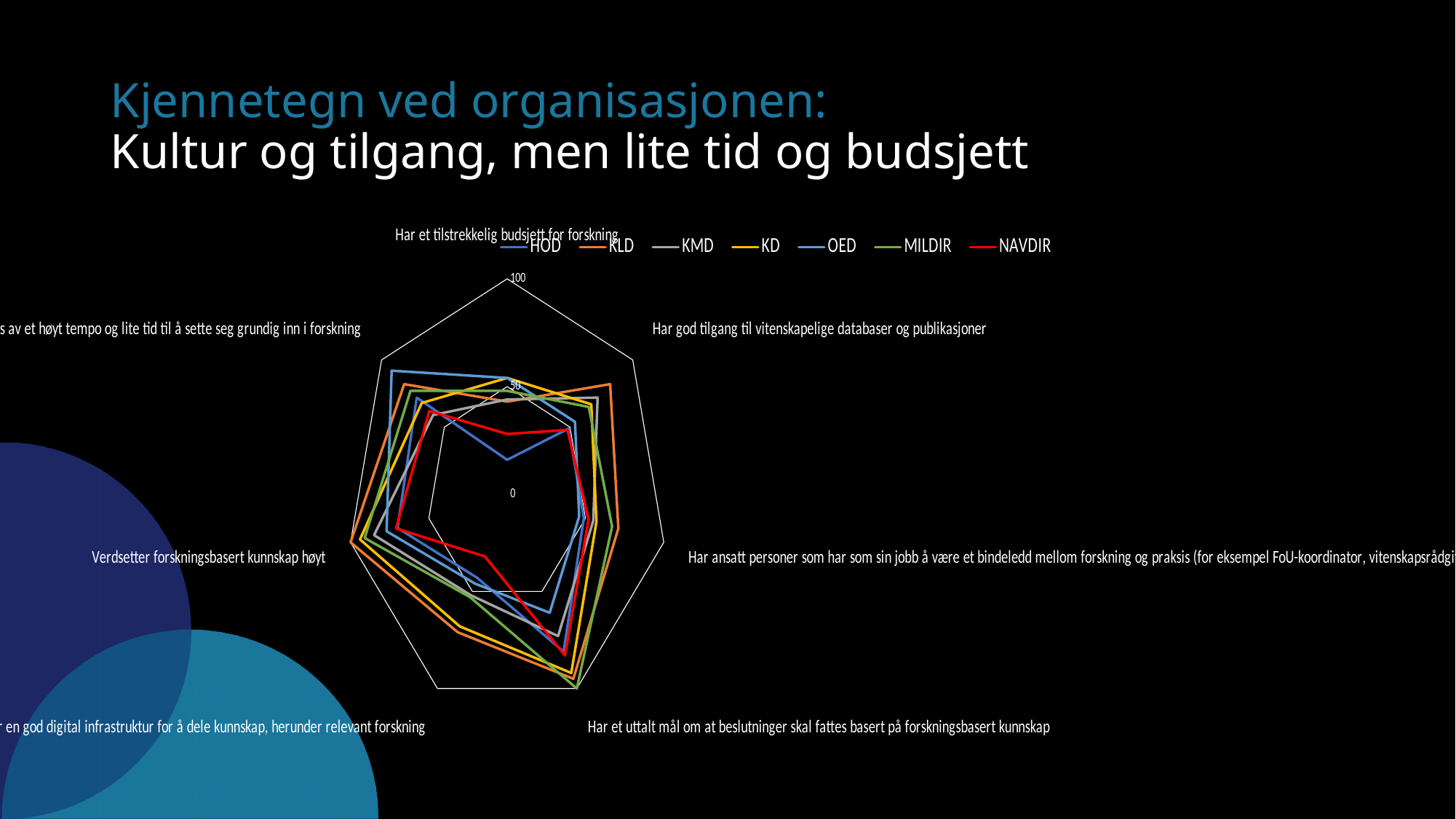
Is the value for NAVDIR on 'Har et uttalt mål om at beslutninger skal fattes basert på forskningsbasert kunnskap' greater or less than 50? greater Which series has the highest value for 'Har et uttalt mål om at beslutninger skal fattes basert på forskningsbasert kunnskap'? MILDIR Which series has the lowest value for 'Har et tilstrekkelig budsjett for forskning'? HOD Which is larger for 'Har et tilstrekkelig budsjett for forskning': KLD or HOD? KLD How many series does the legend list? 7 What is the maximum value shown on the radar chart's scale? 100 Is the value for HOD on 'Har et tilstrekkelig budsjett for forskning' greater or less than 50? less How many axes (categories) does the radar chart have? 7 Is the value for NAVDIR on 'Har et tilstrekkelig budsjett for forskning' greater or less than 50? less What kind of chart is shown on the slide? Radar chart